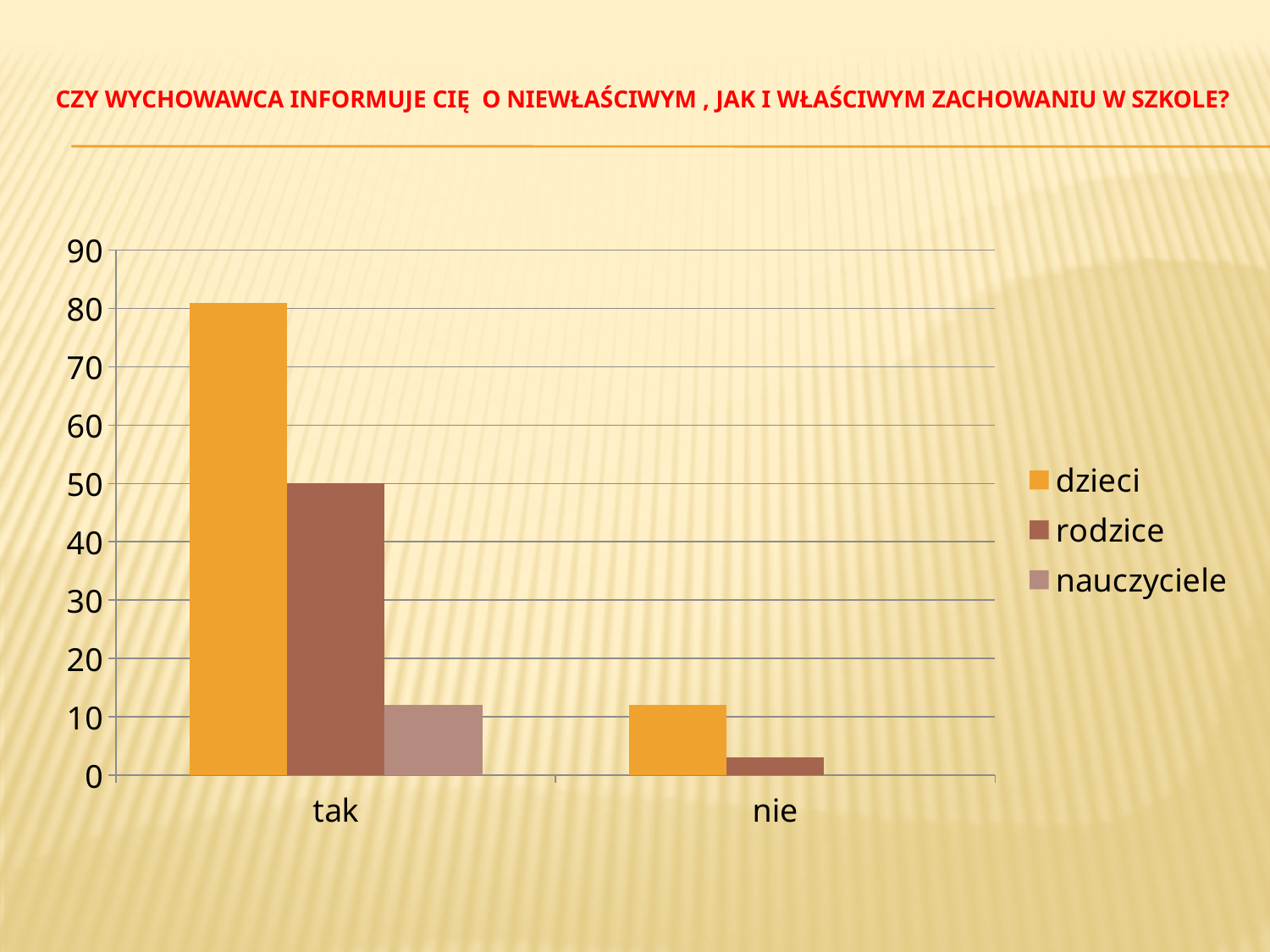
Which series has the lowest bar in the tak category? nauczyciele How many categories are shown on the x axis? 2 What kind of chart is shown on the slide? bar chart Which series has the highest bar in the tak category? dzieci Is the value for dzieci in the tak category greater or less than 70? greater Is the value for dzieci in the nie category greater or less than 20? less Which is larger in the tak category, the value for dzieci or the value for rodzice? dzieci Do the values for dzieci rise or fall from tak to nie? fall Is the value for nauczyciele in the tak category greater or less than 20? less What is the value for rodzice in the tak category? 50 How many series does the legend list? 3